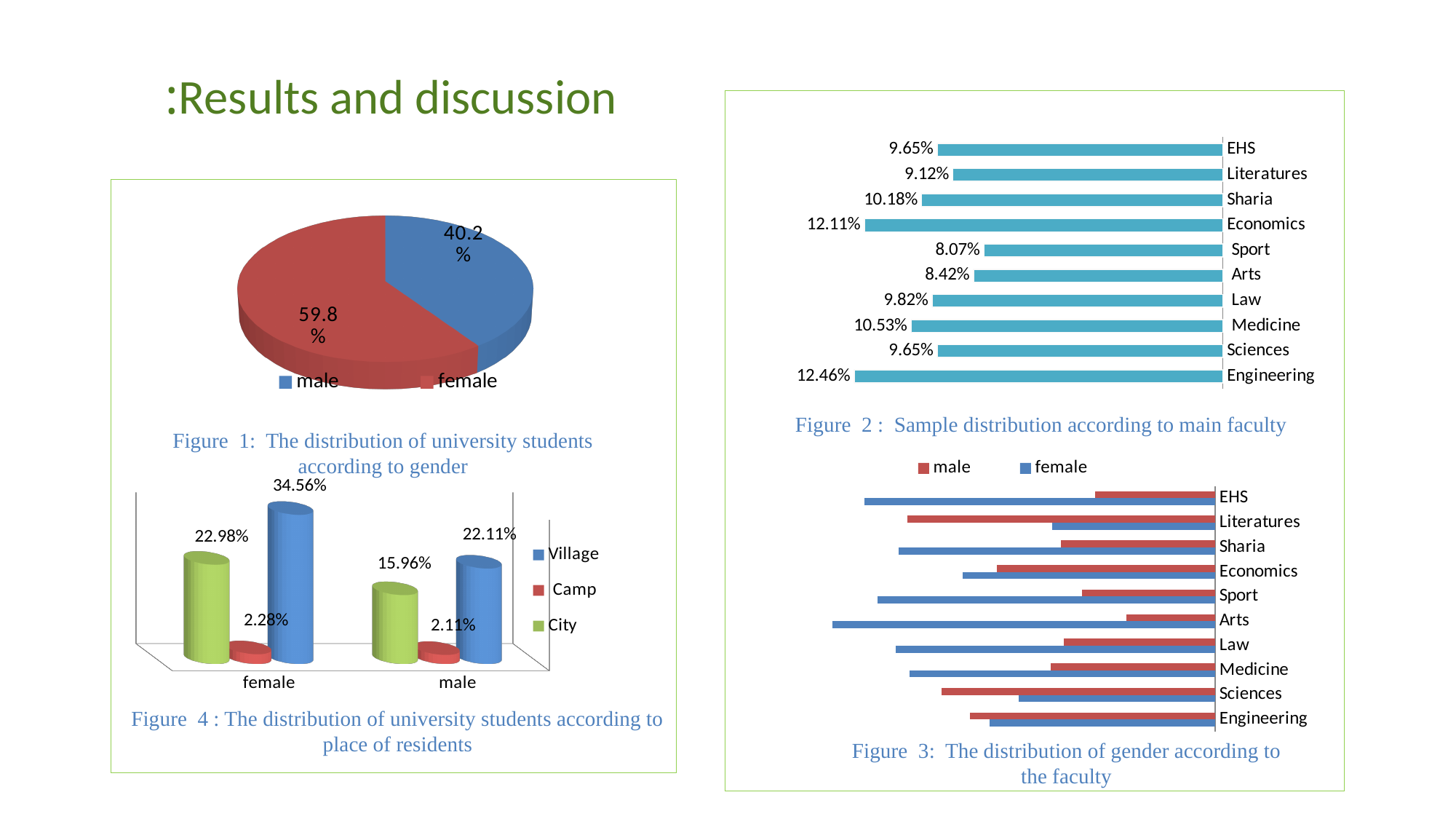
In Figure 4, what is the Village value for female? 34.56% In Figure 4, how many series does the legend list? 3 In Figure 3, for Arts, which is larger, the male bar or the female bar? female In Figure 2, how many faculties are shown? 10 In Figure 4, what is the difference between the Village values for female and male? 12.45% In Figure 2, which faculty has the highest percentage? Engineering In Figure 3, how many series does the legend list? 2 In Figure 2, what is the value for Medicine? 10.53% In Figure 1, what percentage of university students are female? 59.8% In Figure 2, what is the difference between the values for Economics and Sharia? 1.93% In Figure 2, which faculty has the lowest percentage? Sport What kind of chart is Figure 1? pie chart